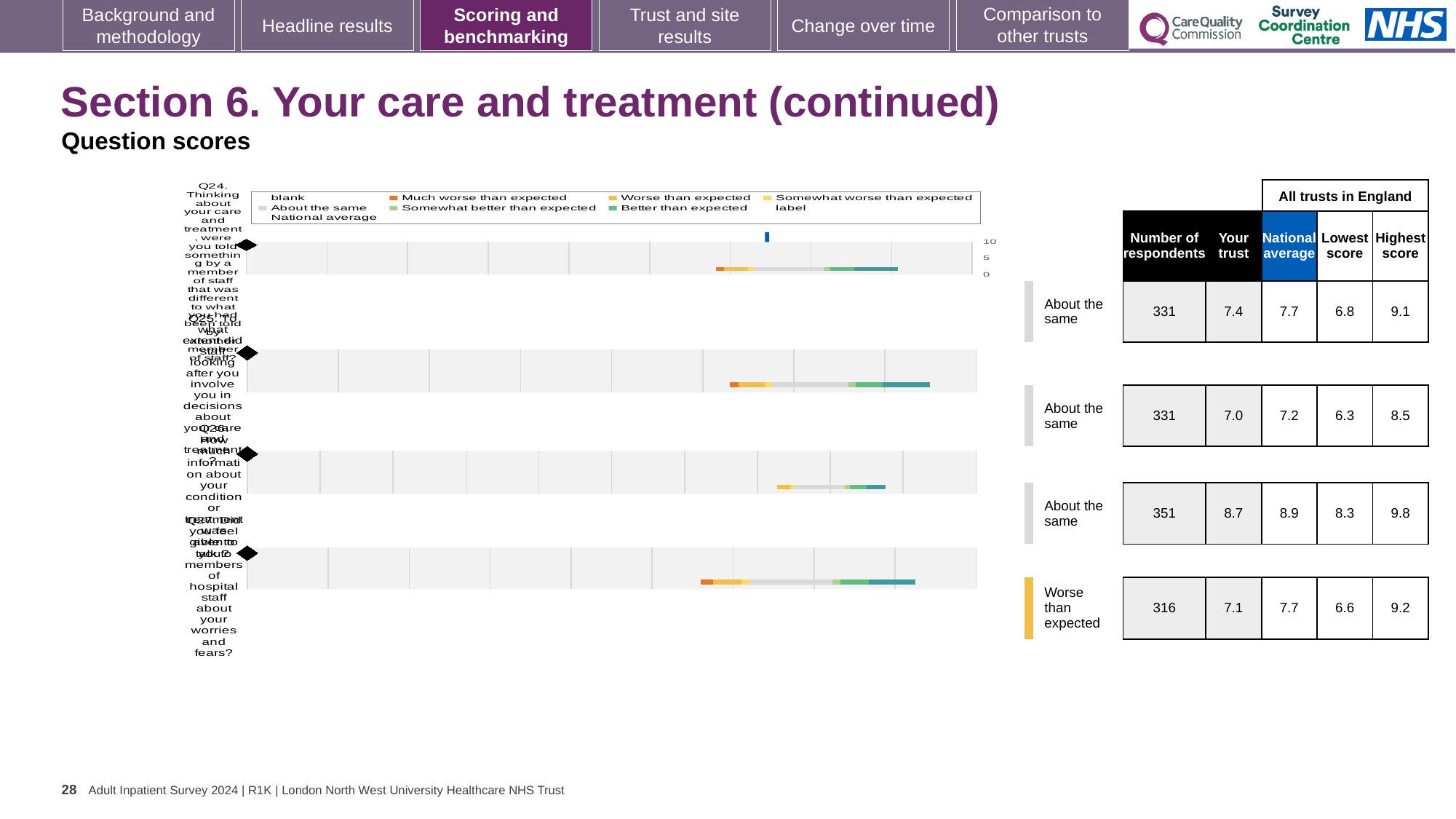
For the bottom chart (Q27), what is the lowest score among all trusts in England? 6.6 For the top chart (Q24), what is the national average score shown in the table? 7.7 For the top chart (Q24), what is the 'Your trust' score shown in the table? 7.4 For the third chart (Q26), what is the highest score among all trusts in England? 9.8 For the top chart (Q24), what is the number of respondents shown in the table? 331 Which of the four charts has the lowest number of respondents in the table? The bottom chart (Q27), 316 Which of the four charts has the highest 'Your trust' score in the table? The third chart (Q26), 8.7 For the third chart (Q26), what is the difference between the national average and the 'Your trust' score? 0.2 For the second chart (Q25), which is larger: the 'Your trust' score or the national average? National average How many question charts are shown on the slide? 4 What kind of chart is used for each question on this slide? Bar chart For the bottom chart (Q27), what benchmark category is shown next to it? Worse than expected